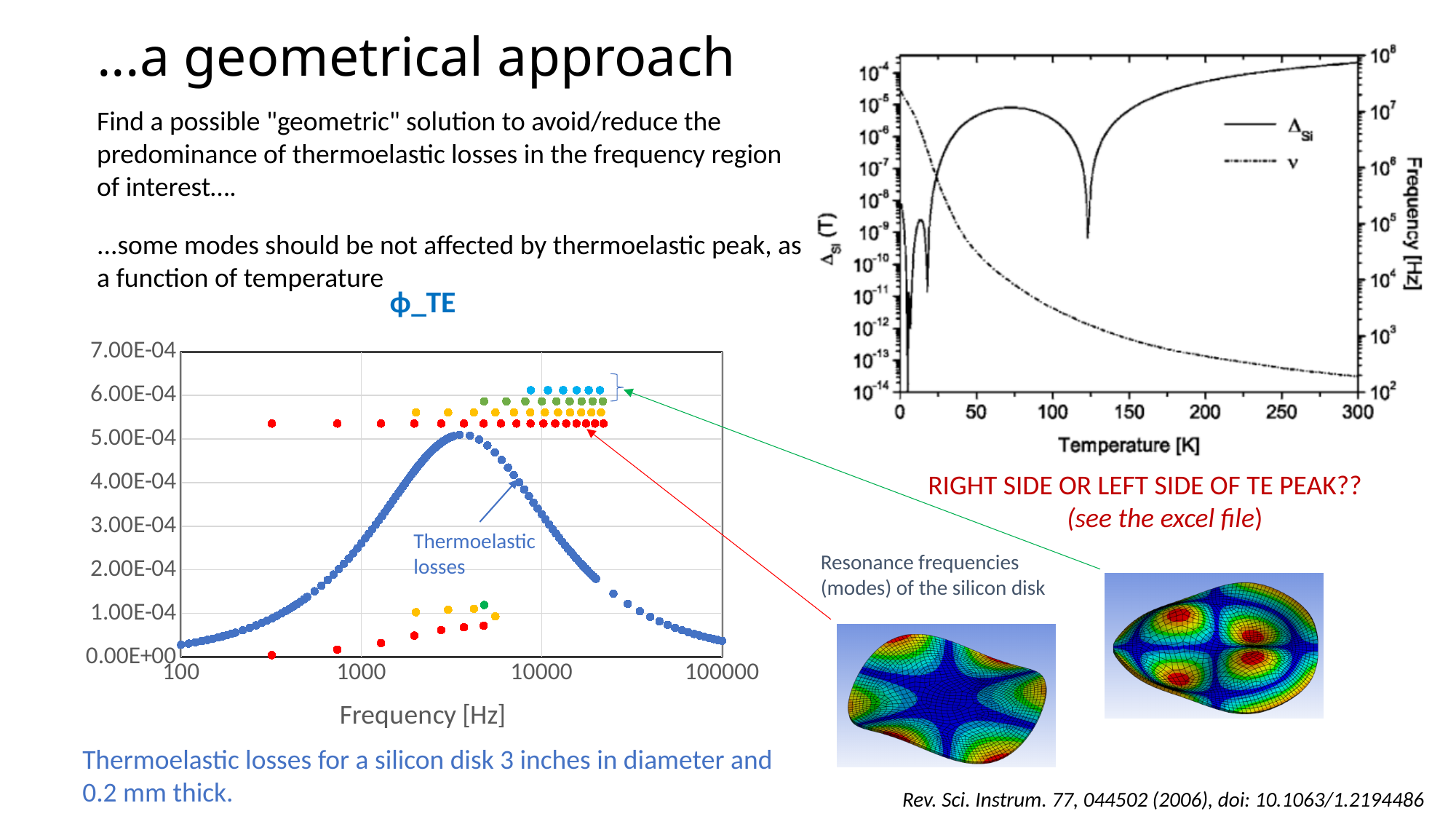
In the ϕ_TE chart, is the thermoelastic losses value at 1000 Hz greater or less than 3.00E-04? less In the top-right chart, is the ν (frequency) value at 300 K greater or less than 10^3 Hz? less In the ϕ_TE chart, is the thermoelastic losses value at 100000 Hz greater or less than 1.00E-04? less In the ϕ_TE chart, how do the thermoelastic losses change as frequency increases from 100 Hz to 100000 Hz? rise to a peak then fall How many series does the legend of the top-right chart (Δ_Si versus Temperature) list? 2 In the top-right chart, does the ν (frequency) curve rise or fall as temperature increases from 0 to 300 K? fall What kind of chart is the ϕ_TE chart on the left of the slide? scatter chart In the ϕ_TE chart, what is the highest value shown on the y axis? 7.00E-04 In the top-right chart, what is the label of the x axis? Temperature [K] In the ϕ_TE chart, what is the label of the x axis? Frequency [Hz]